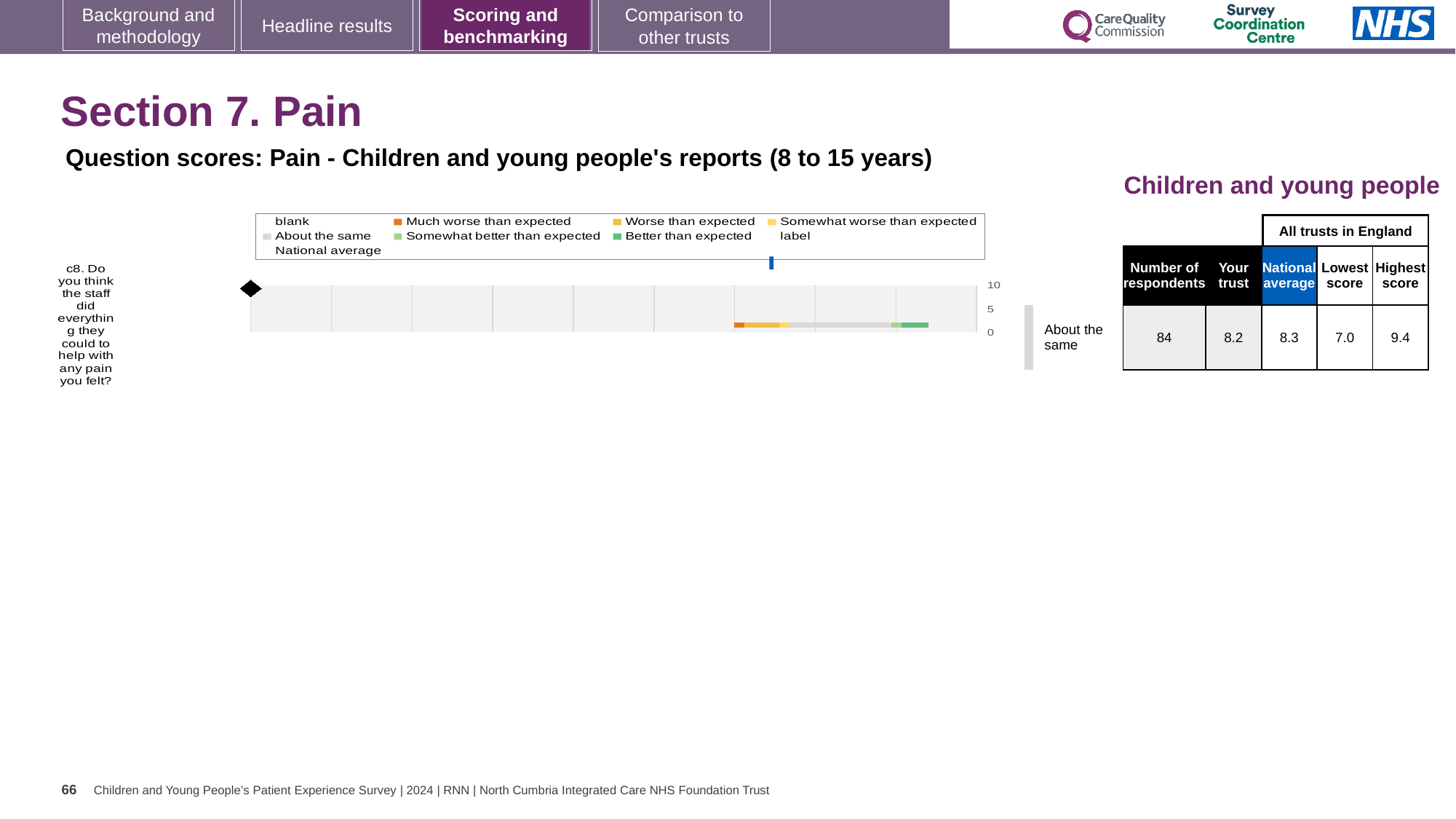
How many survey questions are plotted in the chart? 1 What kind of chart is used to show the question score for c8? bar chart Which benchmark category is the trust's score for question c8 placed in? About the same What is the national average score for question c8 shown in the table? 8.3 What is the lowest score among all trusts in England for question c8? 7.0 Which colour does the legend use for 'Much worse than expected'? orange How many respondents answered question c8 according to the table? 84 What is the highest value shown on the chart's score axis? 10 What is the 'Your trust' score for question c8 shown in the table next to the chart? 8.2 Which is larger for question c8: the 'Your trust' score or the national average? National average What is the highest score among all trusts in England for question c8? 9.4 What is the difference between the highest and lowest trust scores for question c8? 2.4